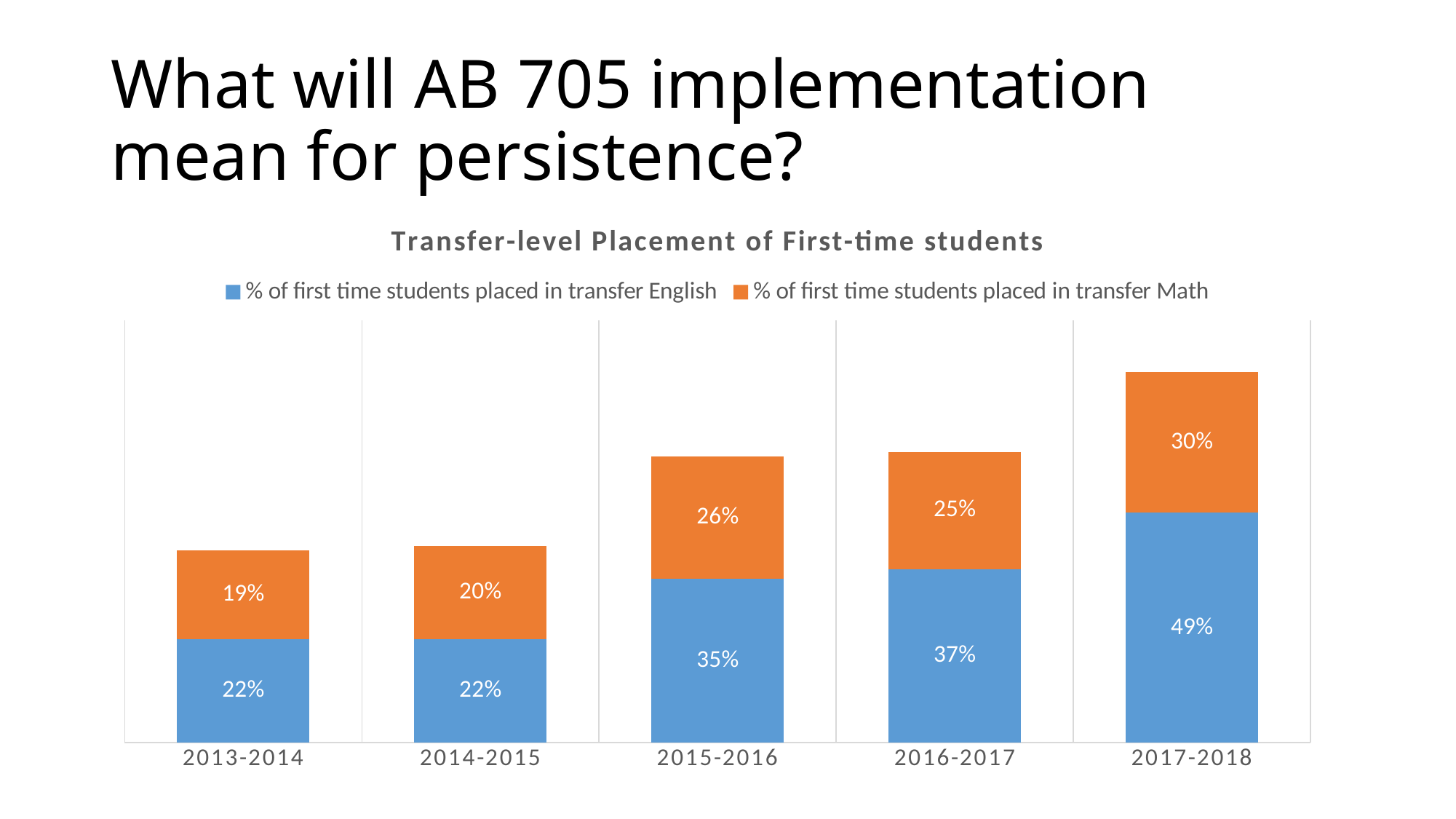
What kind of chart is shown on the slide? Stacked bar chart What is the title of the chart? Transfer-level Placement of First-time students How many academic years are shown on the x axis? 5 Which is larger: the percentage placed in transfer Math in 2016-2017 or in 2015-2016? 2015-2016 How many series does the legend list? 2 Which year has the highest percentage of first time students placed in transfer English? 2017-2018 Which year has the lowest percentage of first time students placed in transfer Math? 2013-2014 What percentage of first time students were placed in transfer English in 2017-2018? 49% What percentage of first time students were placed in transfer Math in 2015-2016? 26% What percentage of first time students were placed in transfer Math in 2013-2014? 19% What is the total of the stacked bar for 2017-2018? 79% What is the difference between the percentage of first time students placed in transfer English in 2017-2018 and in 2016-2017? 12%